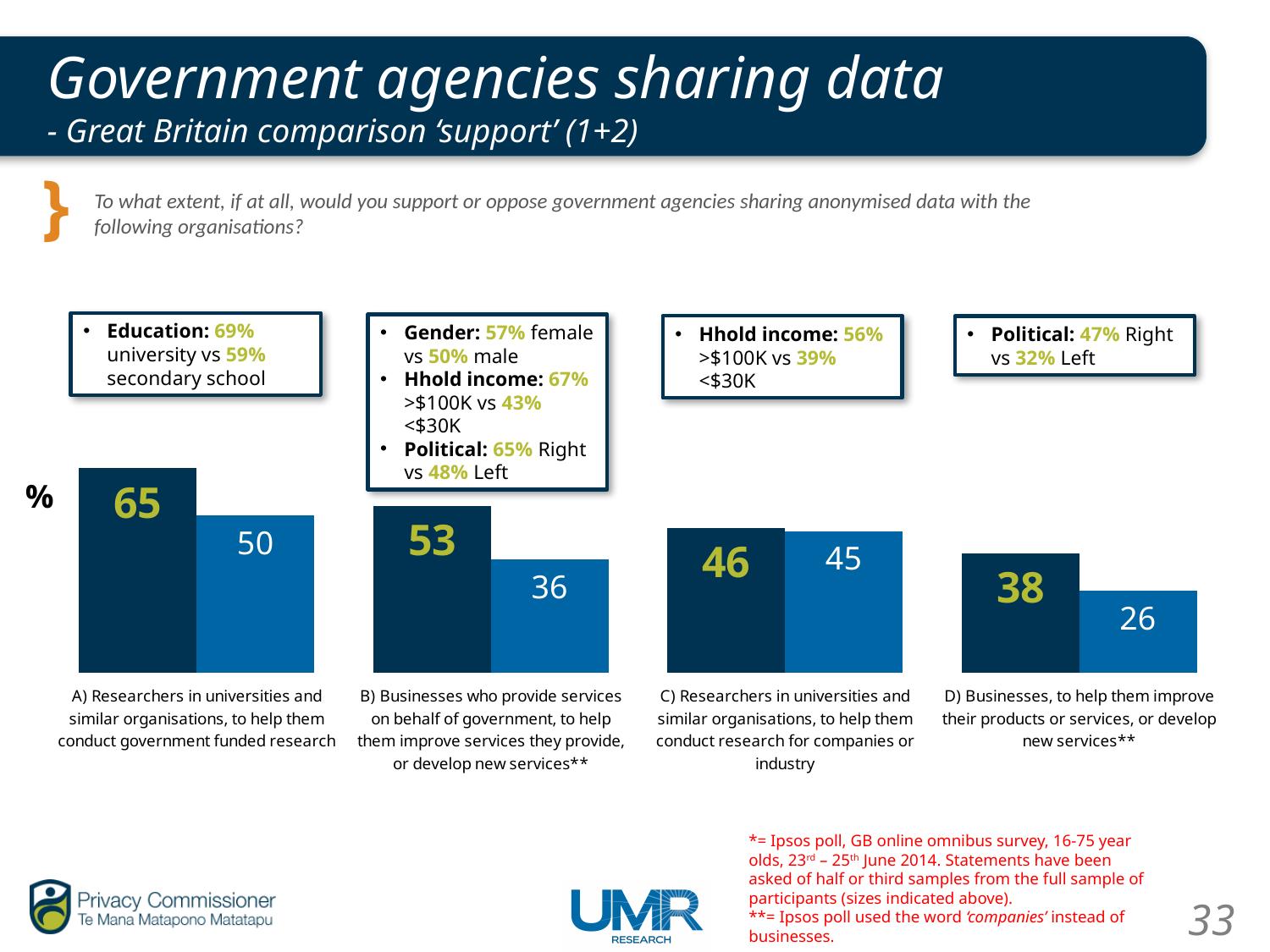
What is the value of the light blue bar for category D) Businesses, to help them improve their products or services, or develop new services? 26 Which category has the lowest light blue bar? D) Businesses, to help them improve their products or services, or develop new services What is the value of the light blue bar for category B) Businesses who provide services on behalf of government? 36 Which category has the highest dark blue bar? A) Researchers in universities and similar organisations, to help them conduct government funded research Which is larger for category C: the dark blue bar or the light blue bar? the dark blue bar What kind of chart is shown on the slide? bar chart What is the value of the dark blue bar for category C) Researchers in universities and similar organisations, to help them conduct research for companies or industry? 46 What is the value of the dark blue bar for category A) Researchers in universities and similar organisations, to help them conduct government funded research? 65 How many categories are shown in the chart? 4 Do the dark blue bar values rise or fall from category A to category D? fall What is the difference between the dark blue bar for category A and the dark blue bar for category D? 27 What is the difference between the dark blue and light blue bars for category B) Businesses who provide services on behalf of government? 17